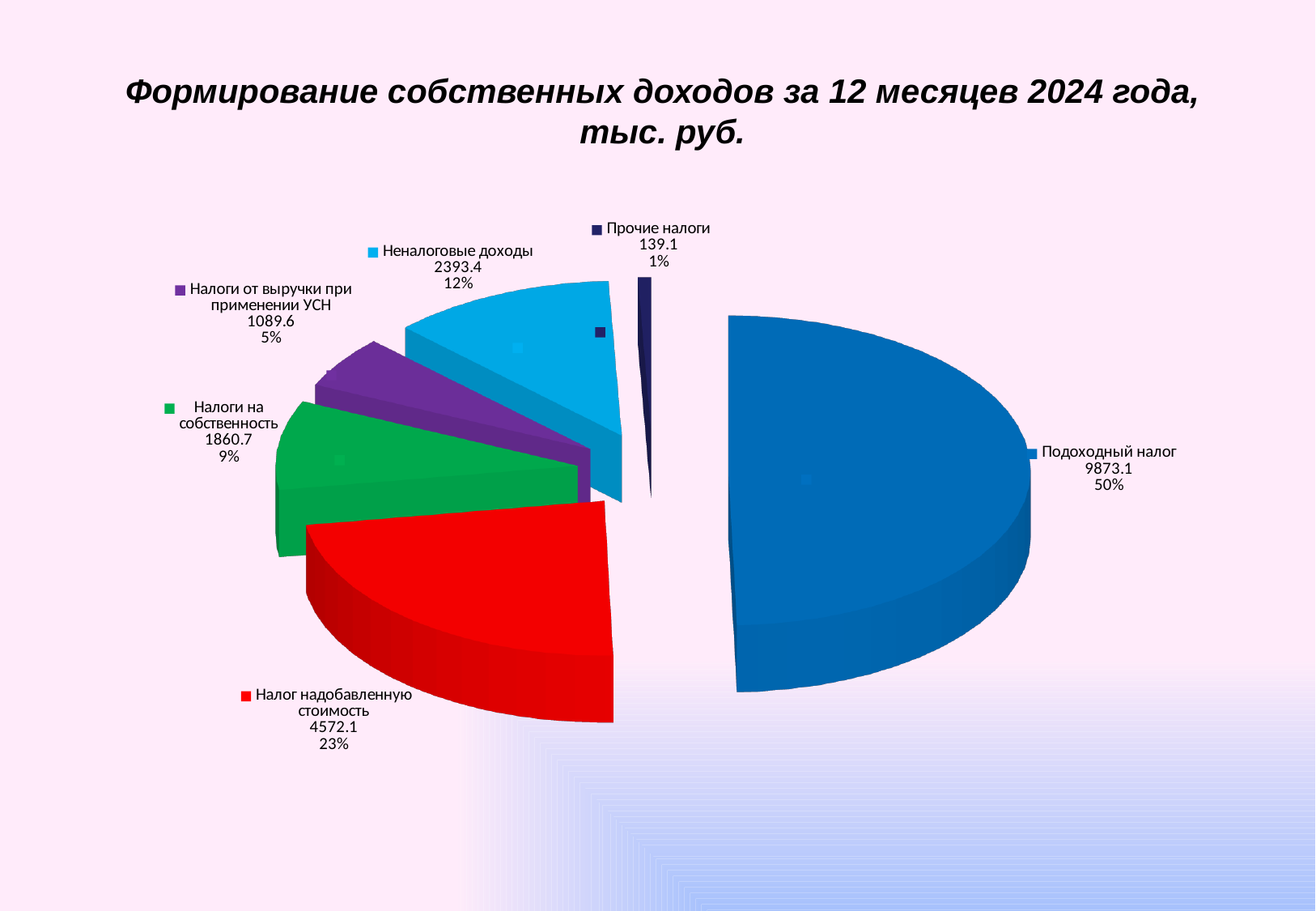
What is the value for Подоходный налог? 9873.1 What is the value for Налог на добавленную стоимость? 4572.1 How many categories are shown in the pie chart? 6 What is the value for Неналоговые доходы? 2393.4 What share of the pie does Налоги на собственность represent? 9% Which is larger, the value for Неналоговые доходы or the value for Налоги на собственность? Неналоговые доходы Which category has the smallest slice of the pie? Прочие налоги What is the difference between the values for Подоходный налог and Налог на добавленную стоимость? 5301.0 Which category has the largest slice of the pie? Подоходный налог What share of the pie does Налог на добавленную стоимость represent? 23% What type of chart is shown on the slide? Pie chart What is the value for Налоги от выручки при применении УСН? 1089.6